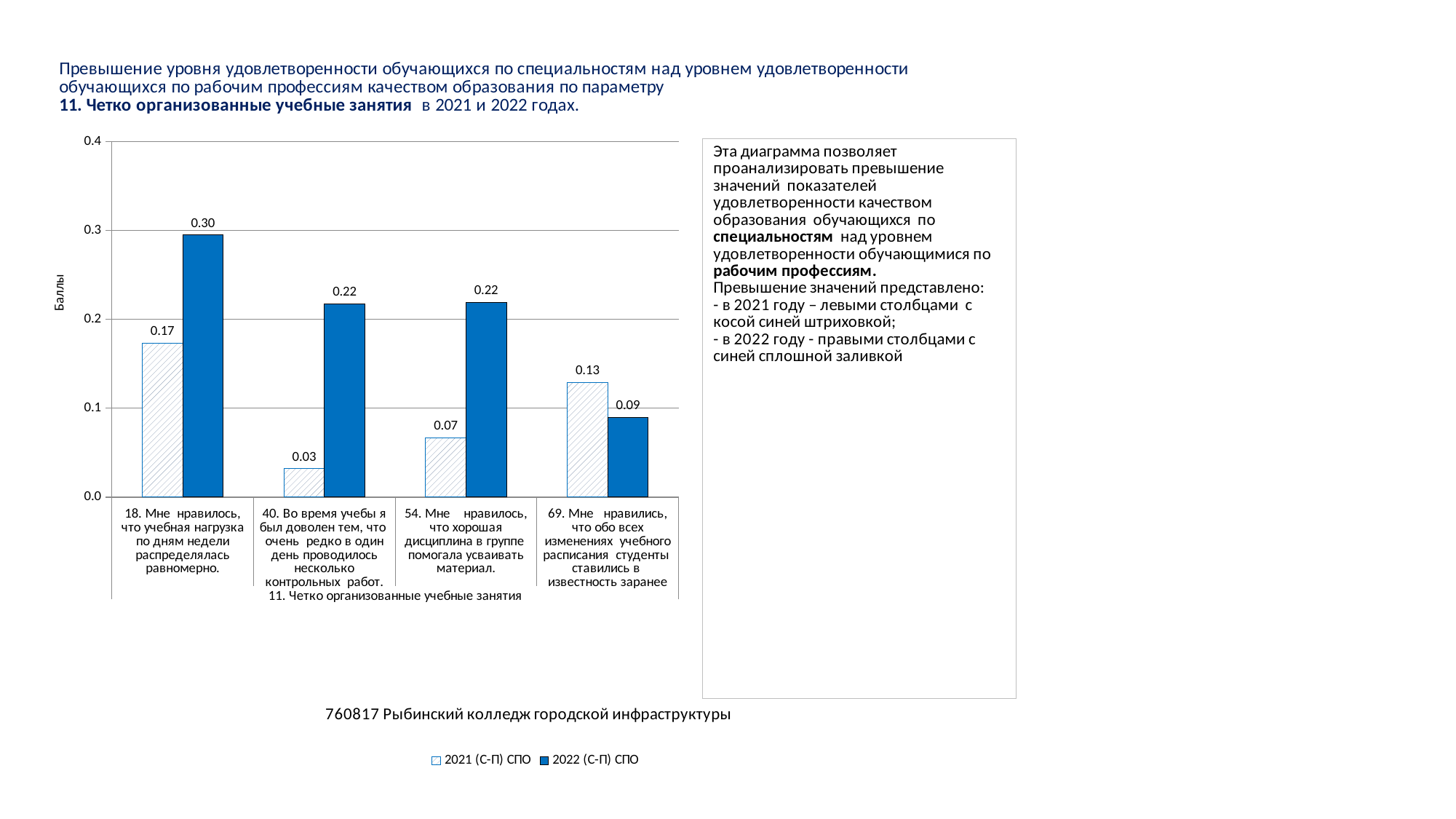
What is the value of the 2022 (С-П) СПО series for category 40 ("Во время учебы я был доволен тем, что очень редко в один день проводилось несколько контрольных работ")? 0.22 What kind of chart is shown on the slide? bar chart What is the label of the vertical axis of the chart? Баллы Which category has the highest value in the 2022 (С-П) СПО series? 18. Мне нравилось, что учебная нагрузка по дням недели распределялась равномерно. What is the difference between the 2022 and 2021 values for category 18? 0.13 How many categories are shown on the x axis of the chart? 4 What is the value of the 2021 (С-П) СПО series for category 69 ("Мне нравились, что обо всех изменениях учебного расписания студенты ставились в известность заранее")? 0.13 Is the 2022 (С-П) СПО value for category 54 greater or less than 0.2? greater How many series does the legend list? 2 For category 69, which series has the larger value: 2021 (С-П) СПО or 2022 (С-П) СПО? 2021 (С-П) СПО What is the value of the 2021 (С-П) СПО series for category 18 ("Мне нравилось, что учебная нагрузка по дням недели распределялась равномерно")? 0.17 Which category has the lowest value in the 2021 (С-П) СПО series? 40. Во время учебы я был доволен тем, что очень редко в один день проводилось несколько контрольных работ.